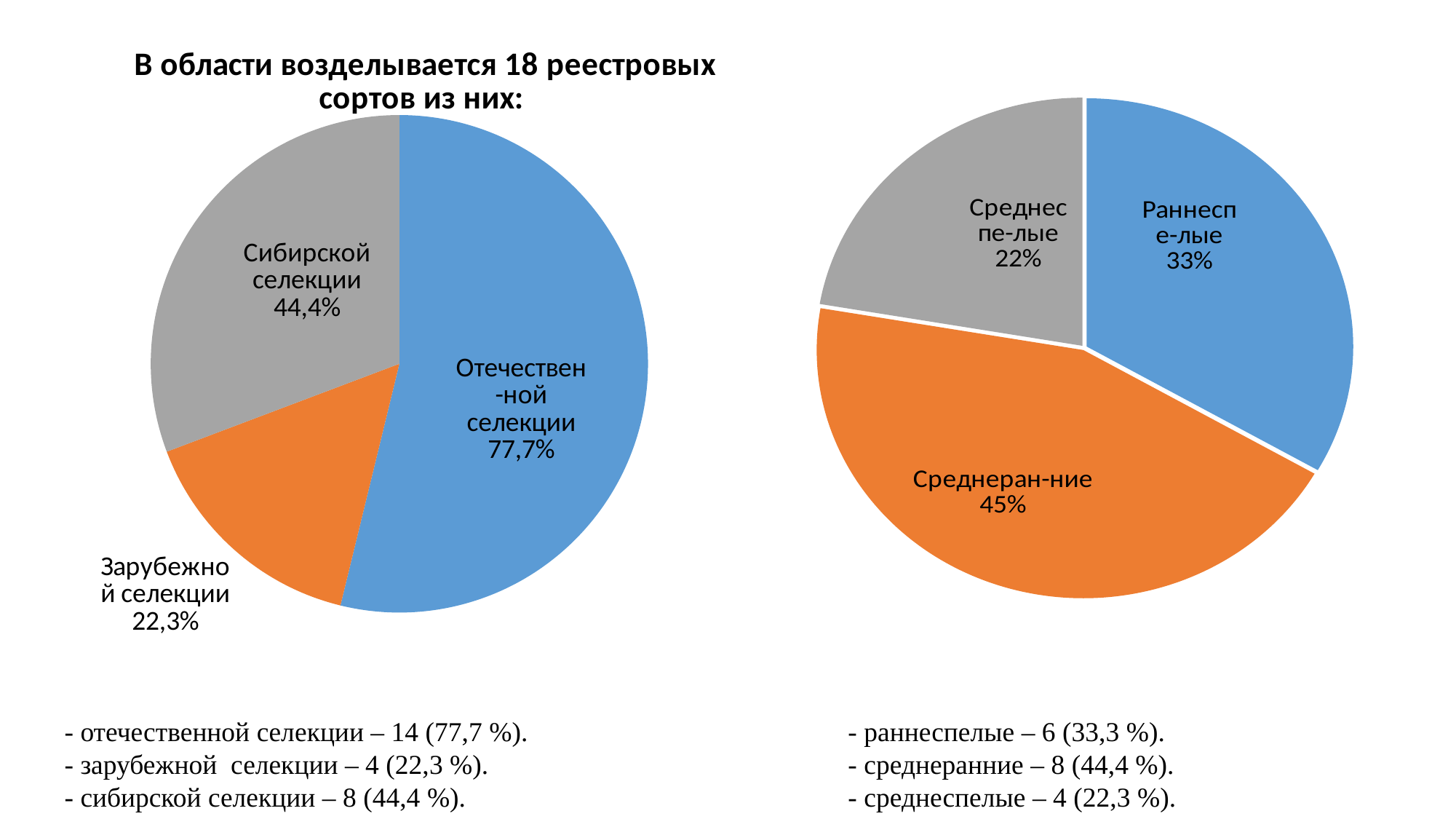
In the left pie chart, which category has the largest slice? Отечественной селекции In the right pie chart, what percentage is shown for Среднеранние? 45% In the right pie chart, which category has the largest share? Среднеранние In the left pie chart, what percentage is shown for Отечественной селекции? 77,7% What type of chart is shown on the left side of the slide? Pie chart In the left pie chart, what percentage is shown for Сибирской селекции? 44,4% How many slices does the right pie chart have? 3 In the right pie chart, which is larger: Раннеспелые or Среднеспелые? Раннеспелые In the right pie chart, what percentage is shown for Раннеспелые? 33% In the right pie chart, what is the difference in percentage points between Среднеранние and Раннеспелые? 12 In the right pie chart, which category has the smallest share? Среднеспелые In the left pie chart, what percentage is shown for Зарубежной селекции? 22,3%